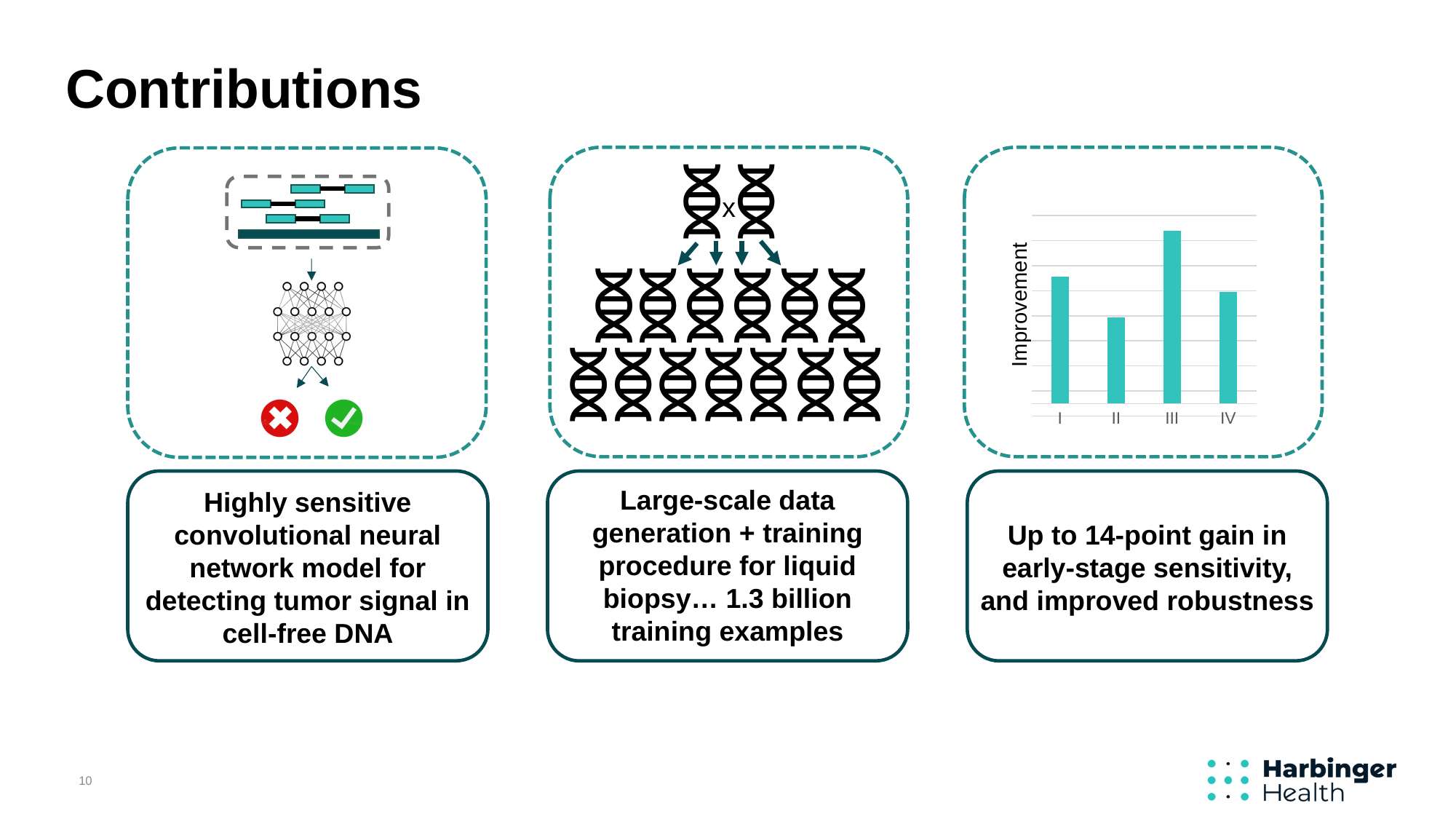
What is the label on the y axis of the bar chart? Improvement Do the bars in the bar chart rise steadily from I to IV? No How many data series are plotted in the bar chart? 1 In the bar chart, is the bar for I or the bar for II taller? I Which category has the lowest bar in the bar chart? II What kind of chart is shown in the right-hand panel? bar chart In the bar chart, is the bar for III or the bar for IV taller? III What are the category labels on the x axis of the bar chart? I, II, III, IV Which category has the highest bar in the bar chart? III In the bar chart, is the bar for II or the bar for IV taller? IV How many categories are shown on the x axis of the bar chart? 4